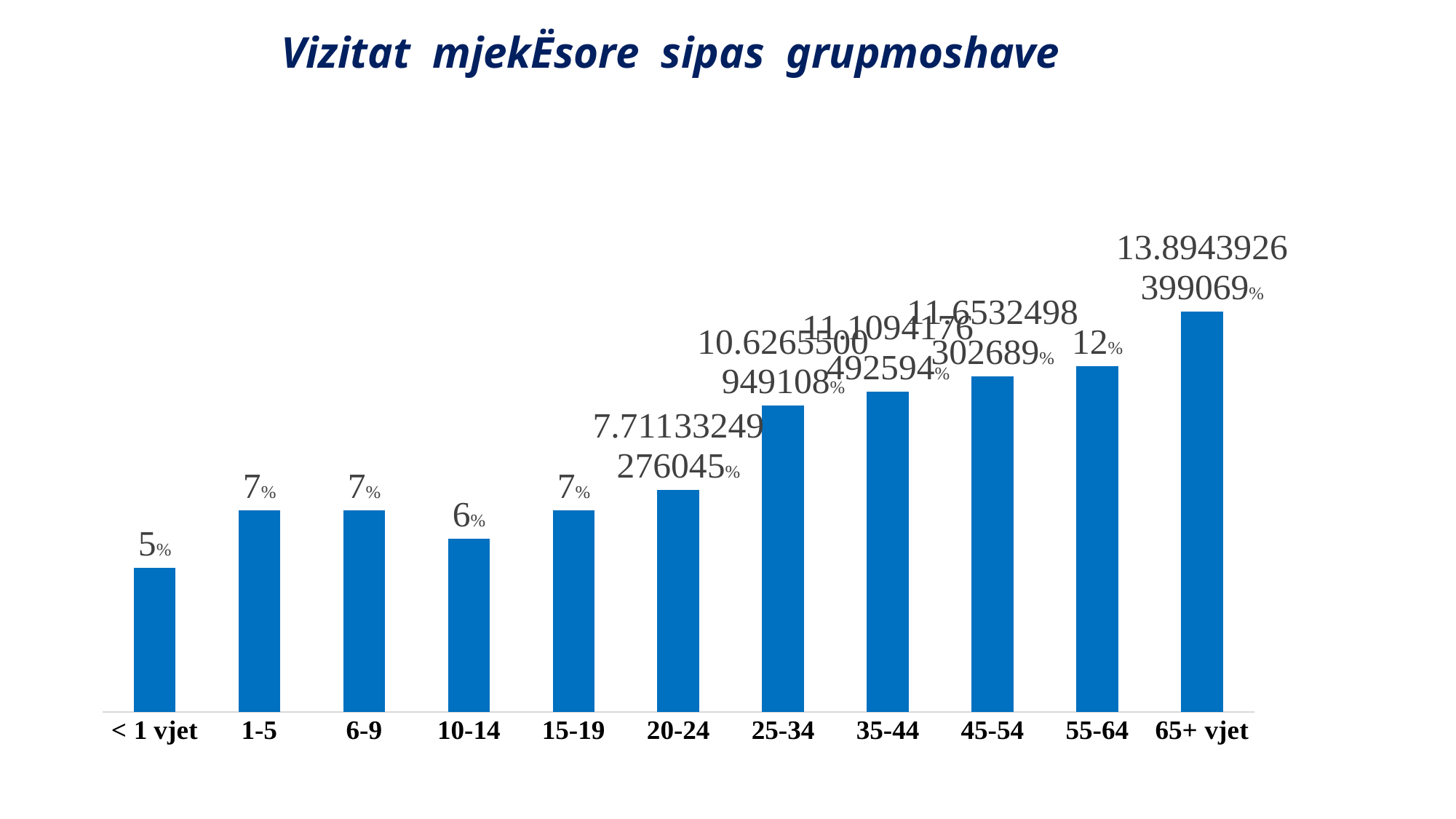
What is the value for the < 1 vjet age group? 5% What is the title of the chart? Vizitat mjekËsore sipas grupmoshave What is the value shown for the 65+ vjet age group? 13.8943926399069% What is the value shown for the 20-24 age group? 7.71133249276045% Which has a larger value, 10-14 or 15-19? 15-19 What is the value for the 55-64 age group? 12% What is the value for the 10-14 age group? 6% Which age group has the lowest value? < 1 vjet What kind of chart is shown on the slide? Bar chart How many age groups are shown on the chart? 11 Which age group has the highest value? 65+ vjet What is the difference between the values for 55-64 and < 1 vjet? 7%